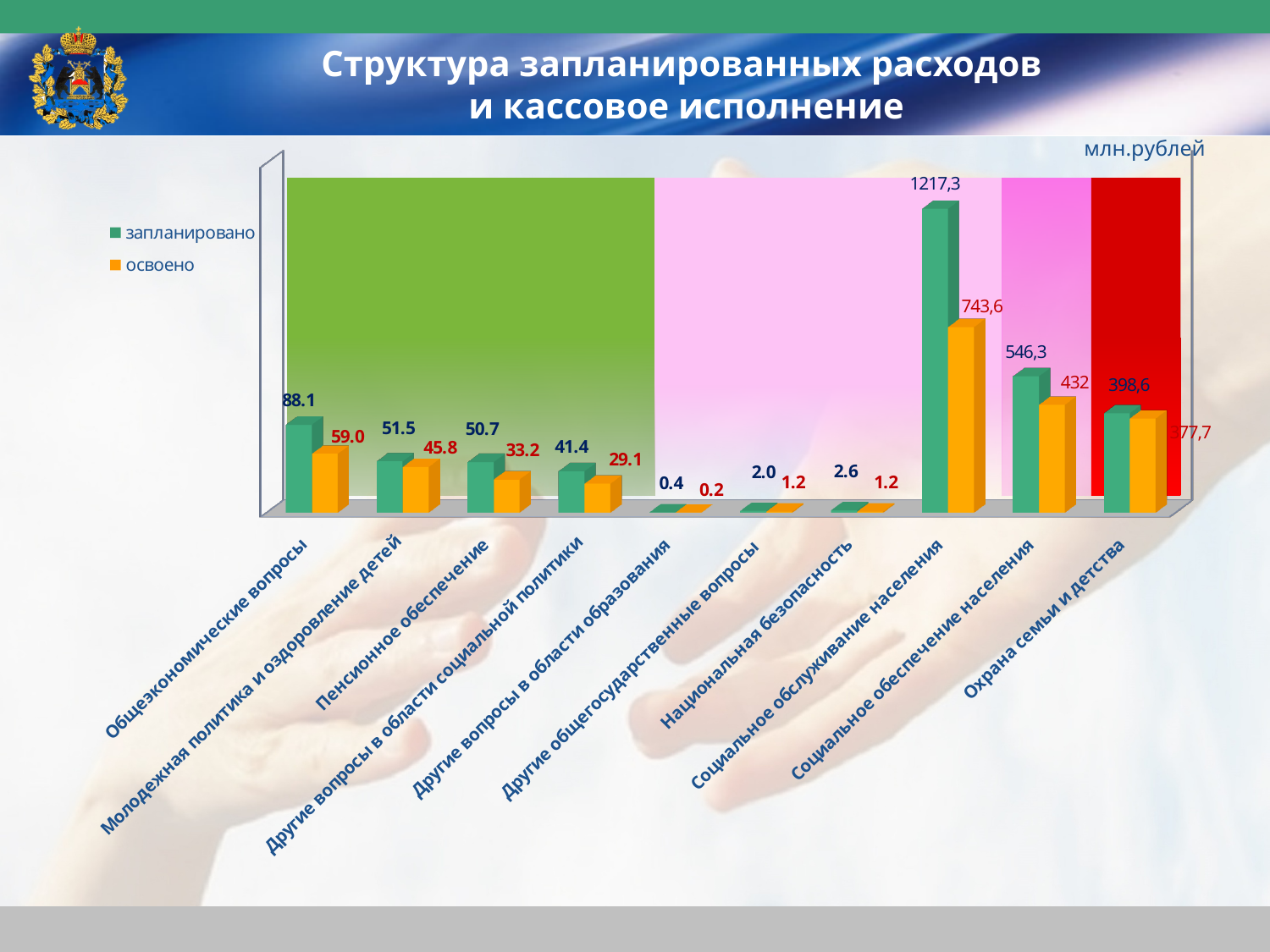
What is the executed (освоено) value for Пенсионное обеспечение? 33.2 Which category has the lowest planned (запланировано) value? Другие вопросы в области образования Which is larger: the executed value for Молодежная политика и оздоровление детей or the executed value for Другие вопросы в области социальной политики? Молодежная политика и оздоровление детей What kind of chart is shown on the slide? Bar chart What is the planned (запланировано) value for Социальное обслуживание населения? 1217,3 What is the planned (запланировано) value for Общеэкономические вопросы? 88.1 How many categories are shown on the x axis? 10 What is the executed (освоено) value for Социальное обеспечение населения? 432 What is the difference between the planned and executed values for Общеэкономические вопросы? 29.1 How many series does the legend list? 2 What is the difference between the planned and executed values for Социальное обслуживание населения? 473,7 Which category has the highest planned (запланировано) value? Социальное обслуживание населения